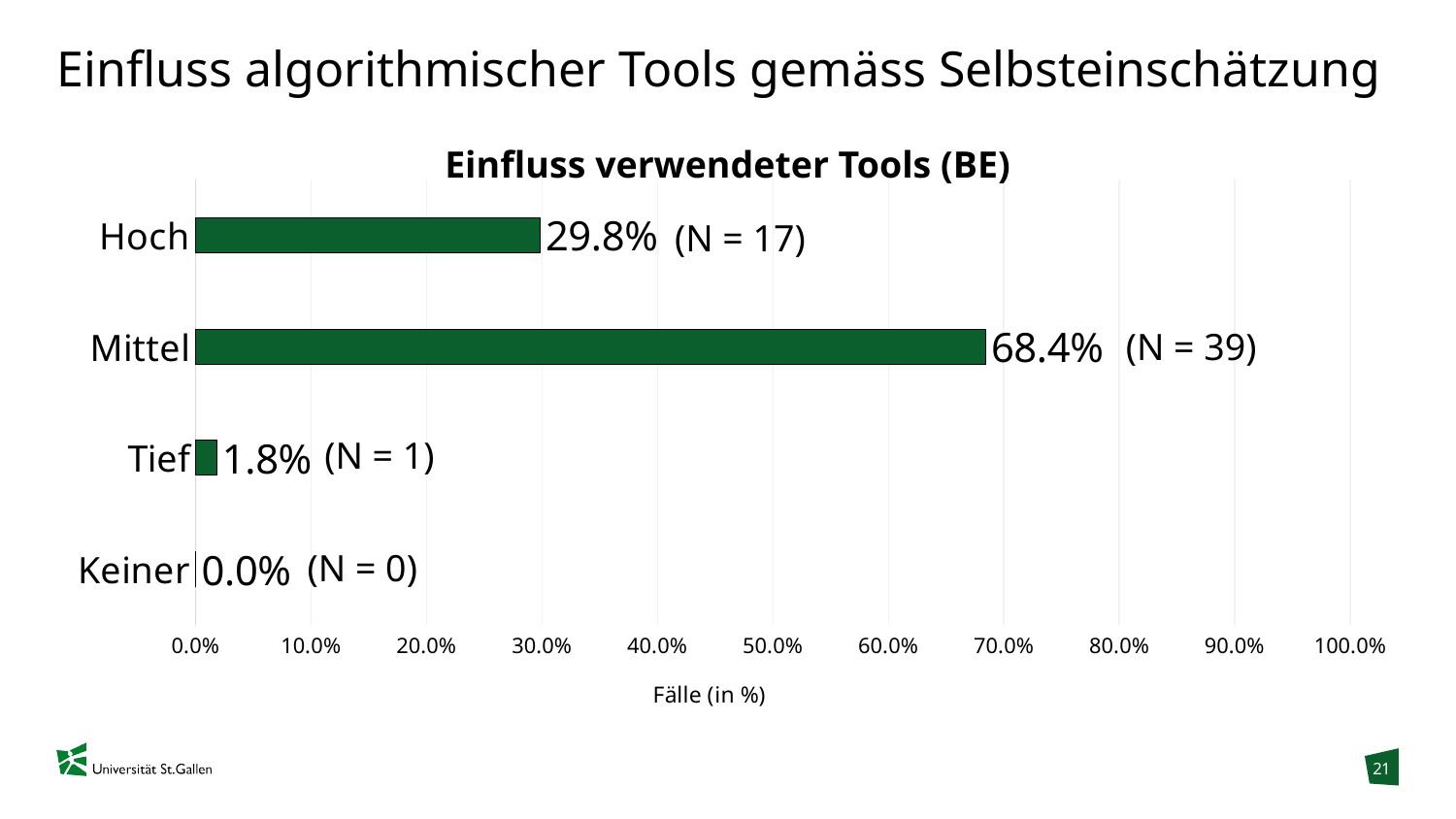
Which category has the highest value? Mittel Which is larger, the value for Hoch or the value for Tief? Hoch What is the value for Hoch? 29.8% What kind of chart is shown? bar chart Which category has the lowest value? Keiner How many categories are shown in the chart? 4 Is the value for Mittel greater or less than 60.0%? greater What is the value for Tief? 1.8% What is the title of the chart? Einfluss verwendeter Tools (BE) What is the value for Mittel? 68.4% What is the difference between the values for Mittel and Hoch? 38.6% How many cases (N) are shown for Mittel? N = 39